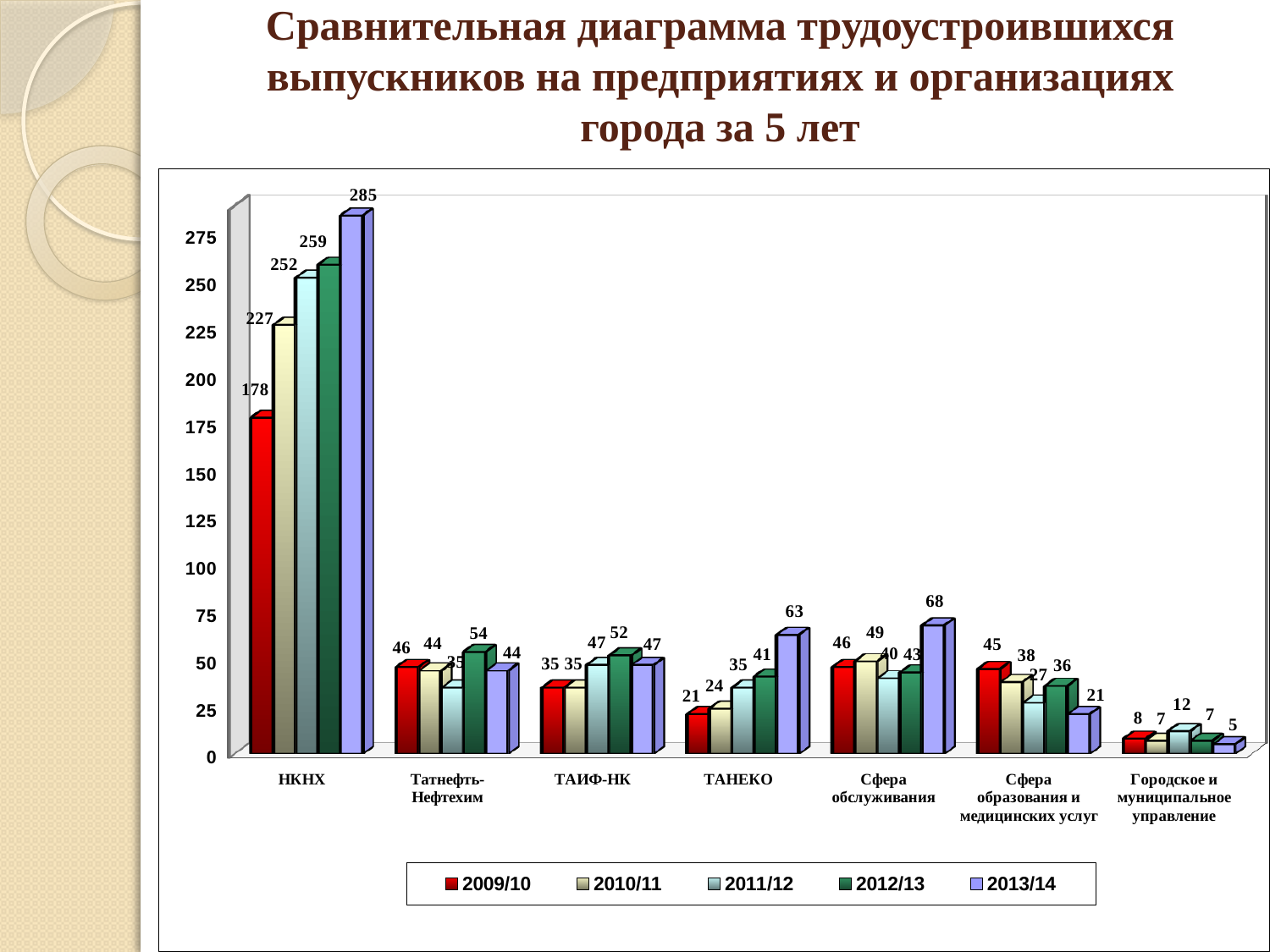
What is the value for НКНХ in the 2013/14 series? 285 What is the value for Сфера обслуживания in the 2013/14 series? 68 Which colour represents the 2009/10 series in the legend? Red What kind of chart is shown on the slide? Bar chart How many categories are shown on the x axis? 7 What is the value for ТАНЕКО in the 2009/10 series? 21 Which category has the lowest value in the 2013/14 series? Городское и муниципальное управление Which is larger for Сфера образования и медицинских услуг: the 2009/10 value or the 2013/14 value? 2009/10 Do the values for НКНХ rise or fall from 2009/10 to 2013/14? Rise Which category has the highest value in the 2012/13 series? НКНХ What is the difference between the 2013/14 and 2009/10 values for НКНХ? 107 How many series does the legend list? 5